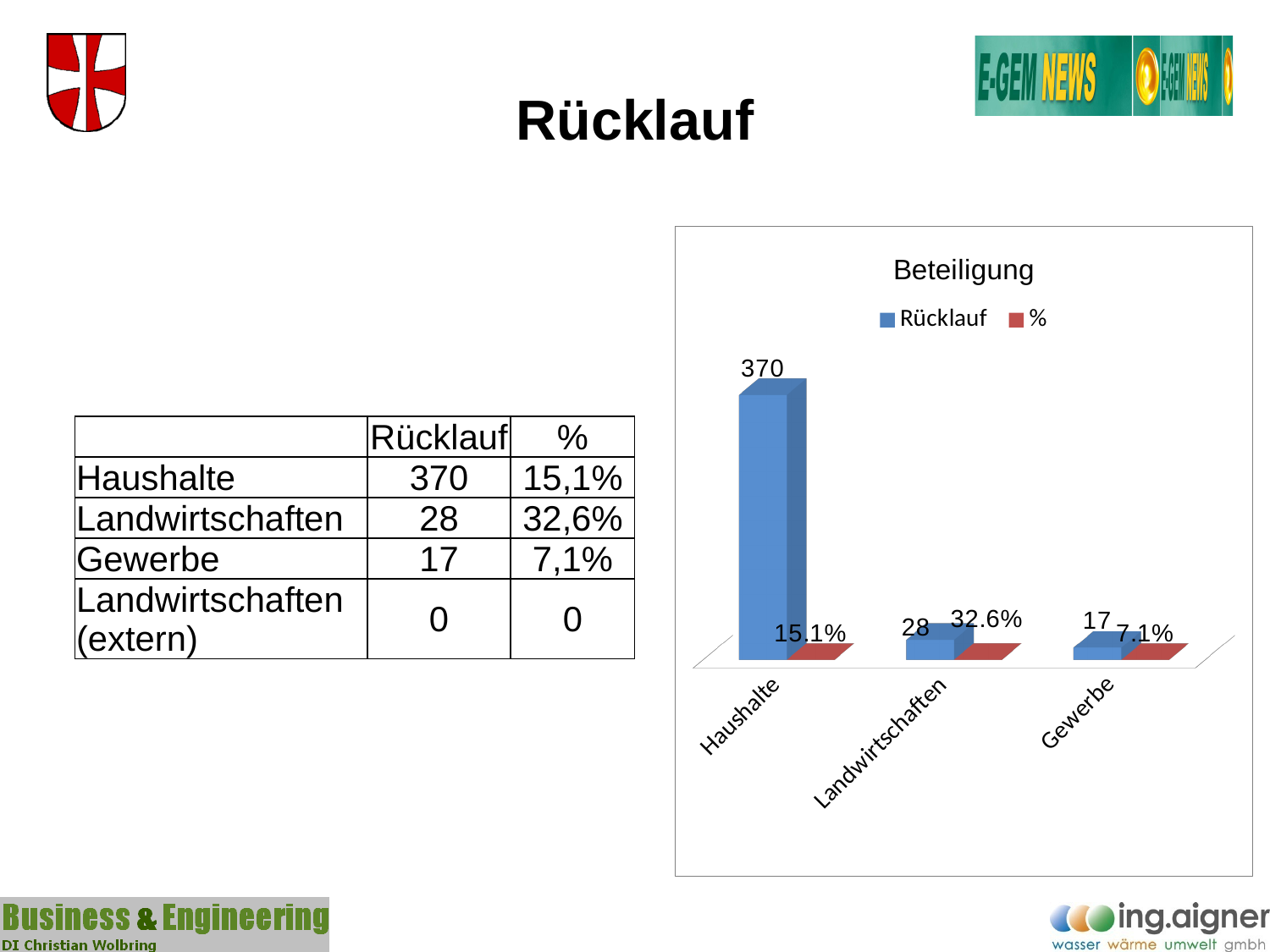
What type of chart is shown on the slide? bar chart What is the % value for Landwirtschaften in the chart? 32.6% What is the Rücklauf value for Landwirtschaften in the chart? 28 What is the Rücklauf value for Haushalte in the chart? 370 Which category has the highest Rücklauf value in the chart? Haushalte Which category has the lowest Rücklauf value in the chart? Gewerbe What is the title of the chart? Beteiligung What is the difference between the Rücklauf values for Haushalte and Landwirtschaften? 342 What is the % value for Gewerbe in the chart? 7.1% How many series does the chart legend list? 2 How many categories are shown on the x axis of the chart? 3 Which is larger, the Rücklauf value for Landwirtschaften or for Gewerbe? Landwirtschaften